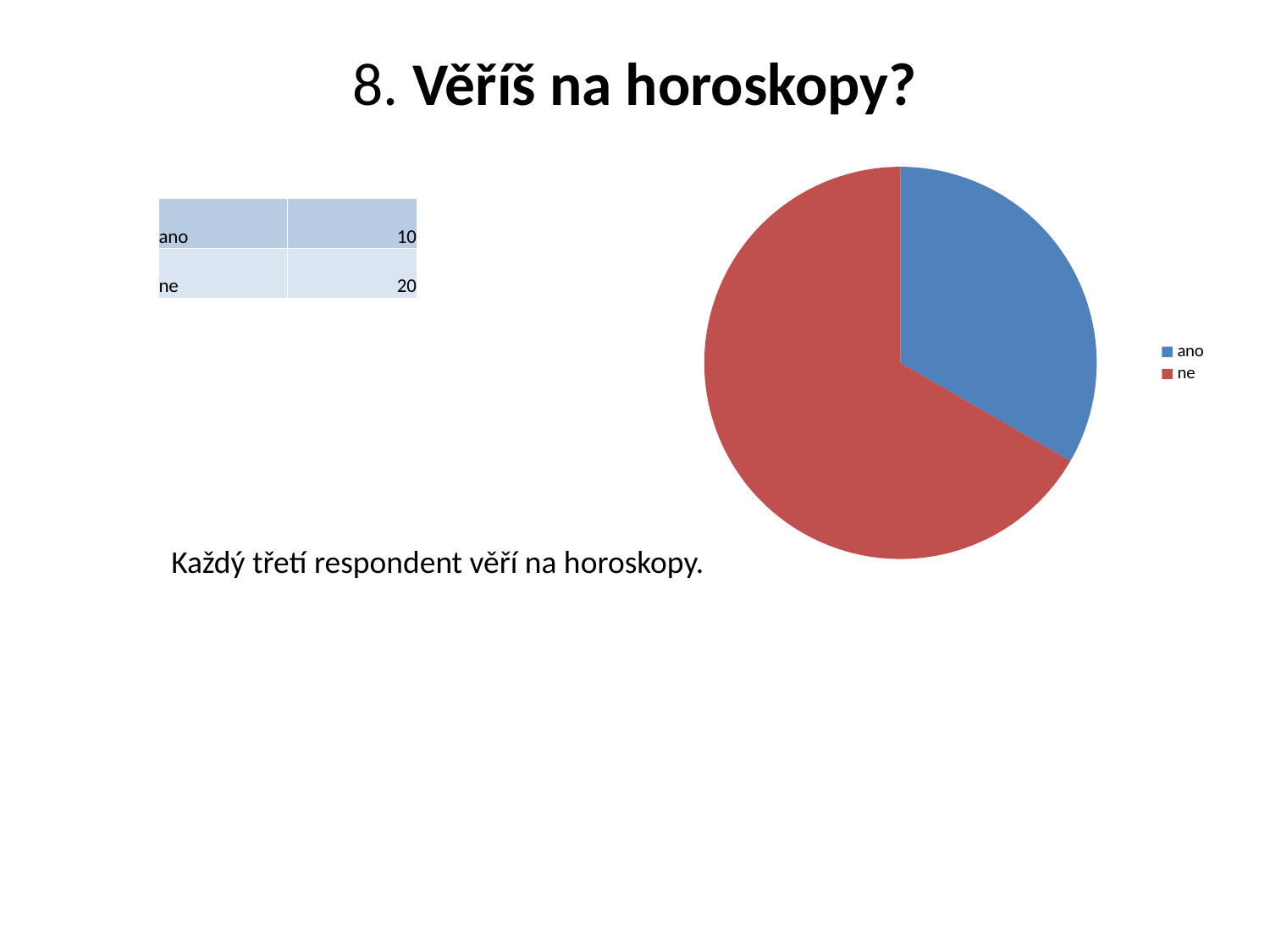
What share of the pie does the "ano" slice represent? one third What is the difference between the value for "ne" and the value for "ano"? 10 Which colour represents "ne" in the pie chart? red What is the total of the two values shown for the pie chart? 30 Which category has the smallest slice of the pie chart? ano Which category has the largest slice of the pie chart? ne Which is larger, the value for "ano" or the value for "ne"? ne What is the value for "ano" shown in the table next to the pie chart? 10 How many entries does the legend of the pie chart list? 2 What is the value for "ne" shown in the table next to the pie chart? 20 How many slices does the pie chart have? 2 What type of chart is shown on the slide? pie chart